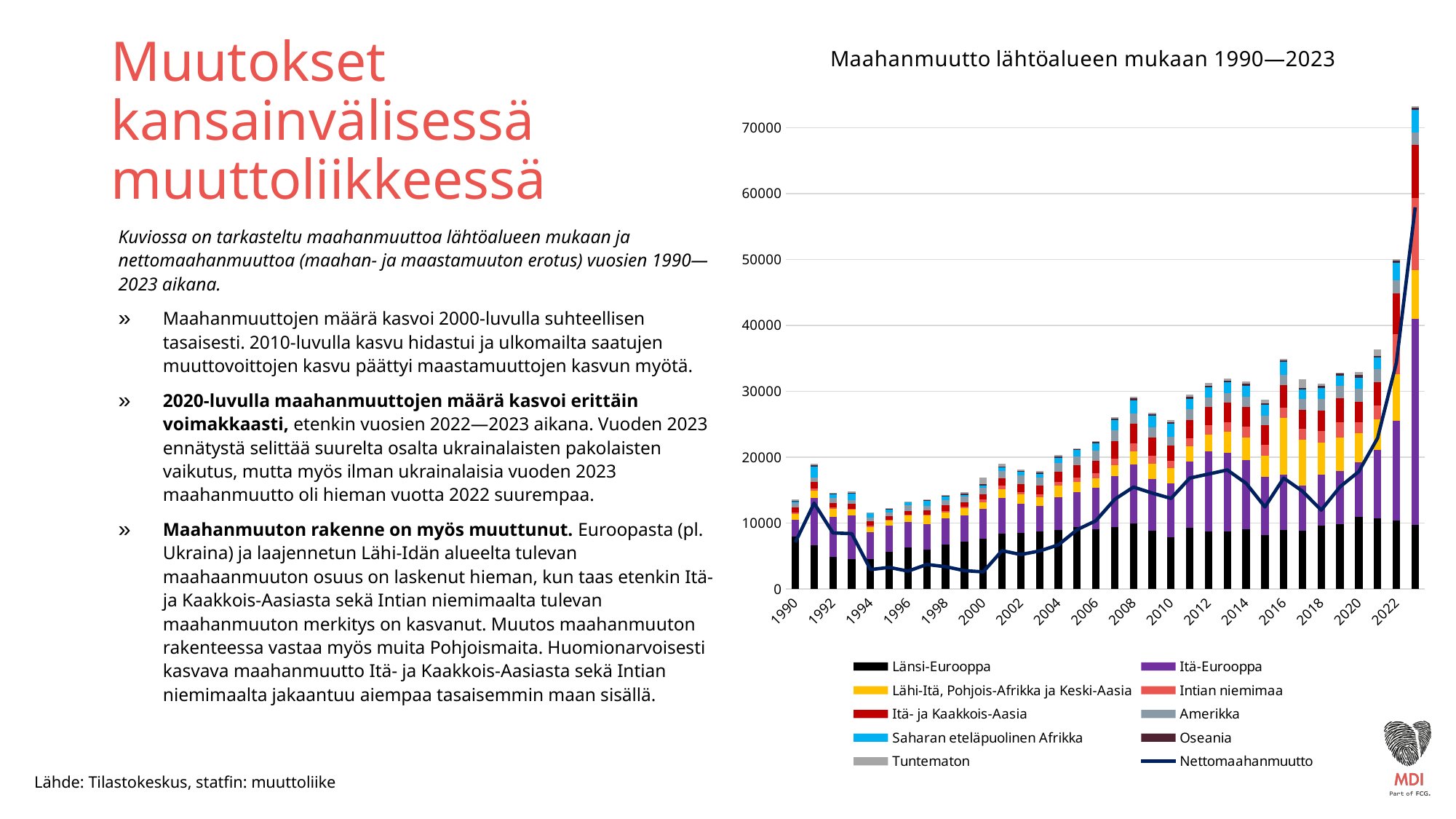
Which year has the highest total immigration bar? 2023 Is the Nettomaahanmuutto value for 2000 greater or less than 10000? less What is the title of the chart? Maahanmuutto lähtöalueen mukaan 1990—2023 Is the Nettomaahanmuutto value for 2023 greater or less than 50000? greater How many series does the chart legend list? 10 Is the total immigration bar for 1990 greater or less than 20000? less Which series is shown as a line rather than as stacked bars? Nettomaahanmuutto What kind of chart is shown on the slide? Stacked bar chart with a line Which year has the larger total immigration bar, 2000 or 2010? 2010 Does the Nettomaahanmuutto line rise or fall from 2020 to 2023? rises How many years (bars) are plotted in the chart? 34